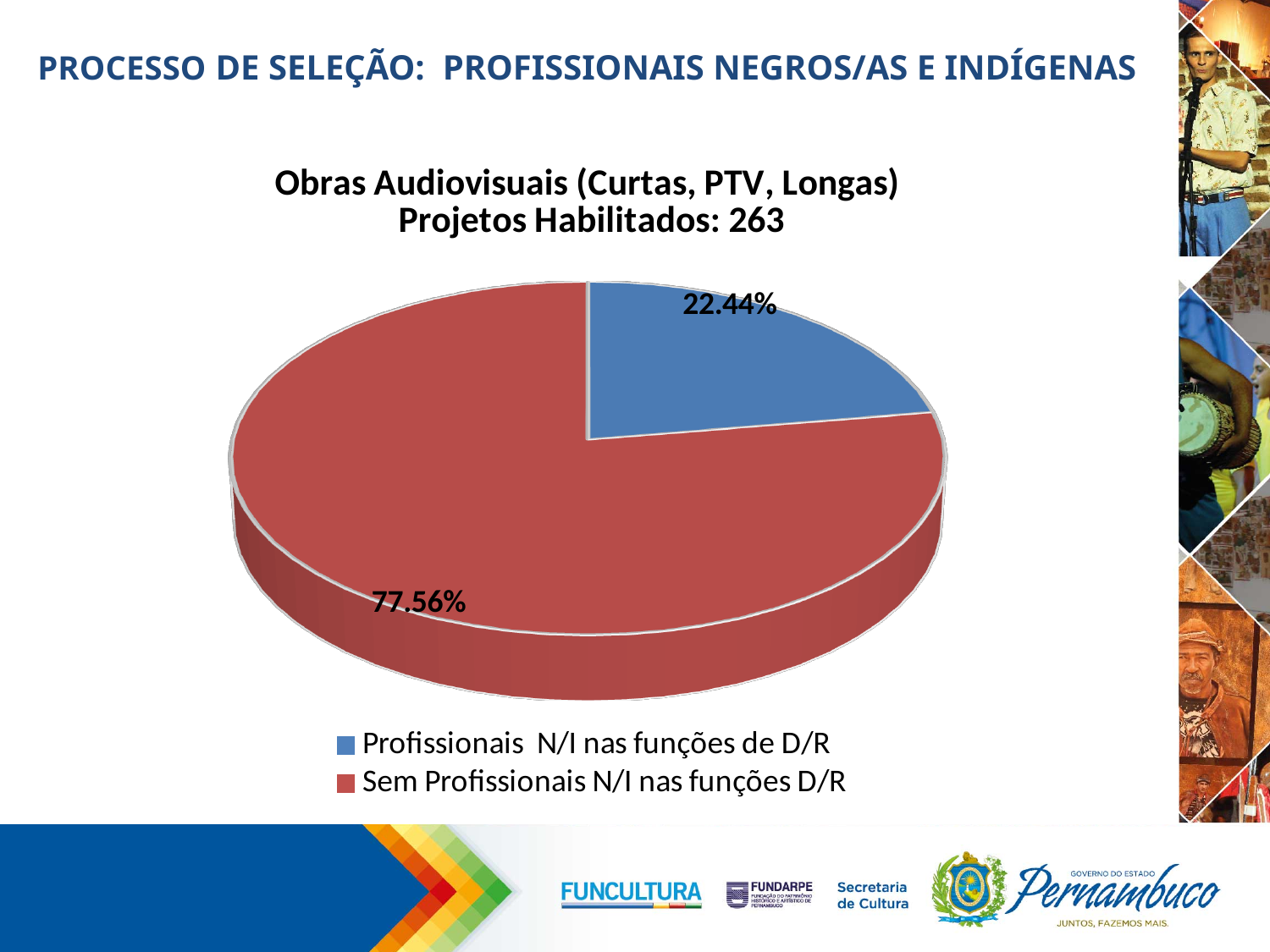
Which slice of the pie is the smallest? Profissionais N/I nas funções de D/R What kind of chart is shown on the slide? pie chart How many slices does the pie chart have? 2 What is the difference in percentage points between the two slices of the pie? 55.12 Which is larger: the slice for "Profissionais N/I nas funções de D/R" or the slice for "Sem Profissionais N/I nas funções D/R"? Sem Profissionais N/I nas funções D/R How many entries does the legend list? 2 Which slice of the pie is the largest? Sem Profissionais N/I nas funções D/R What share of the pie is labelled for "Sem Profissionais N/I nas funções D/R"? 77.56% How many projects were qualified (Projetos Habilitados) according to the chart title? 263 What is the title of the chart? Obras Audiovisuais (Curtas, PTV, Longas) Projetos Habilitados: 263 What share of the pie is labelled for "Profissionais N/I nas funções de D/R"? 22.44% What colour is the slice for "Sem Profissionais N/I nas funções D/R"? red